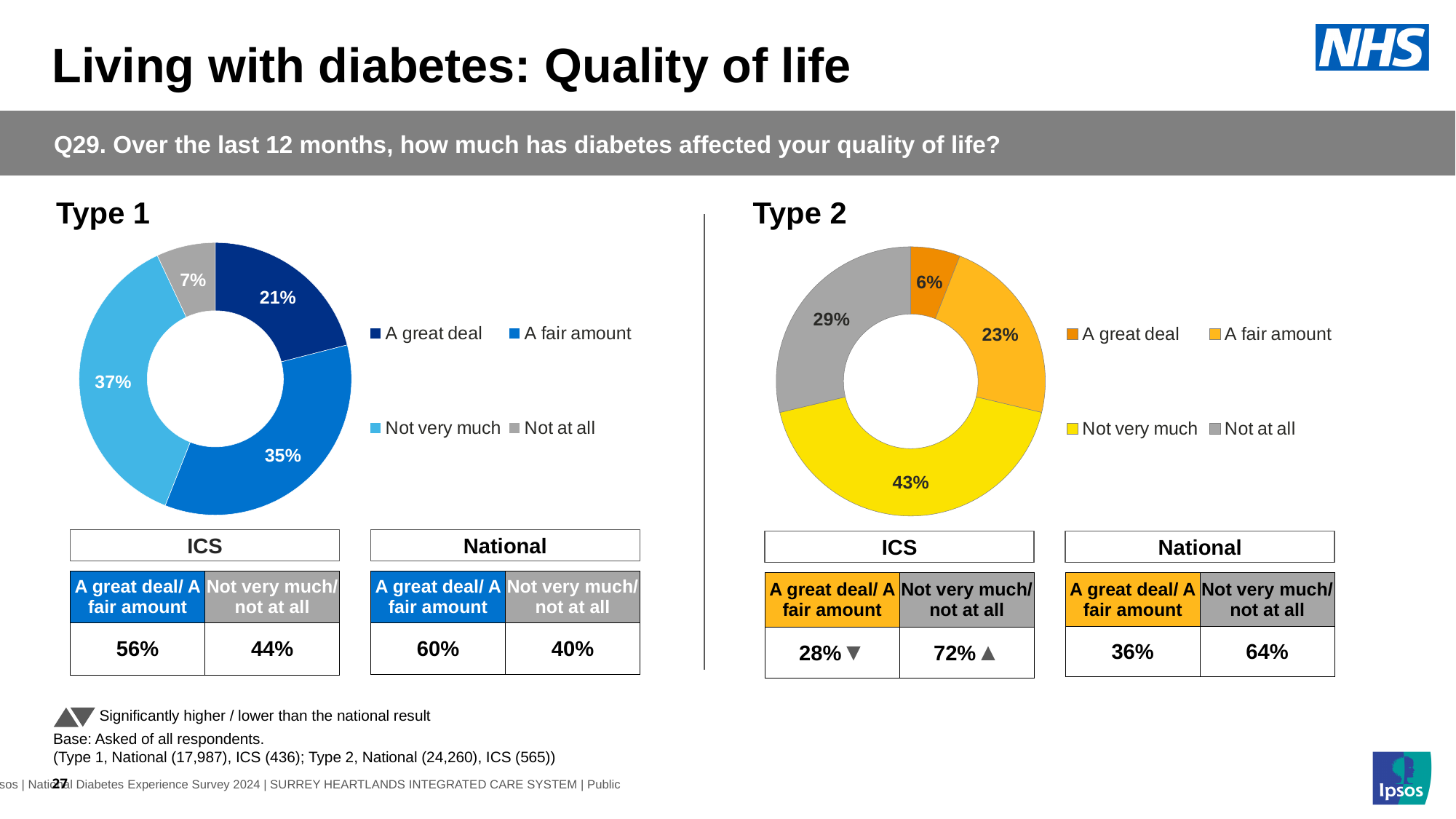
In the Type 1 chart, which category has the largest share? Not very much How many legend entries does the Type 1 chart list? 4 In the Type 2 chart, which is larger: 'A fair amount' or 'Not at all'? Not at all What kind of chart is used for Type 2? Doughnut (pie) chart In the Type 2 chart, what colour represents 'Not very much'? Yellow In the Type 2 chart, which category has the smallest share? A great deal How many categories does the Type 1 chart show? 4 In the Type 1 chart, what is the difference between the 'Not very much' share and the 'Not at all' share? 30 percentage points In the Type 1 chart, what percentage of respondents said 'Not at all'? 7% In the Type 2 chart, what is the combined share of 'A great deal' and 'A fair amount'? 29% In the Type 2 chart, what percentage of respondents said 'Not very much'? 43% In the Type 1 chart, what percentage of respondents said diabetes affected their quality of life 'A great deal'? 21%